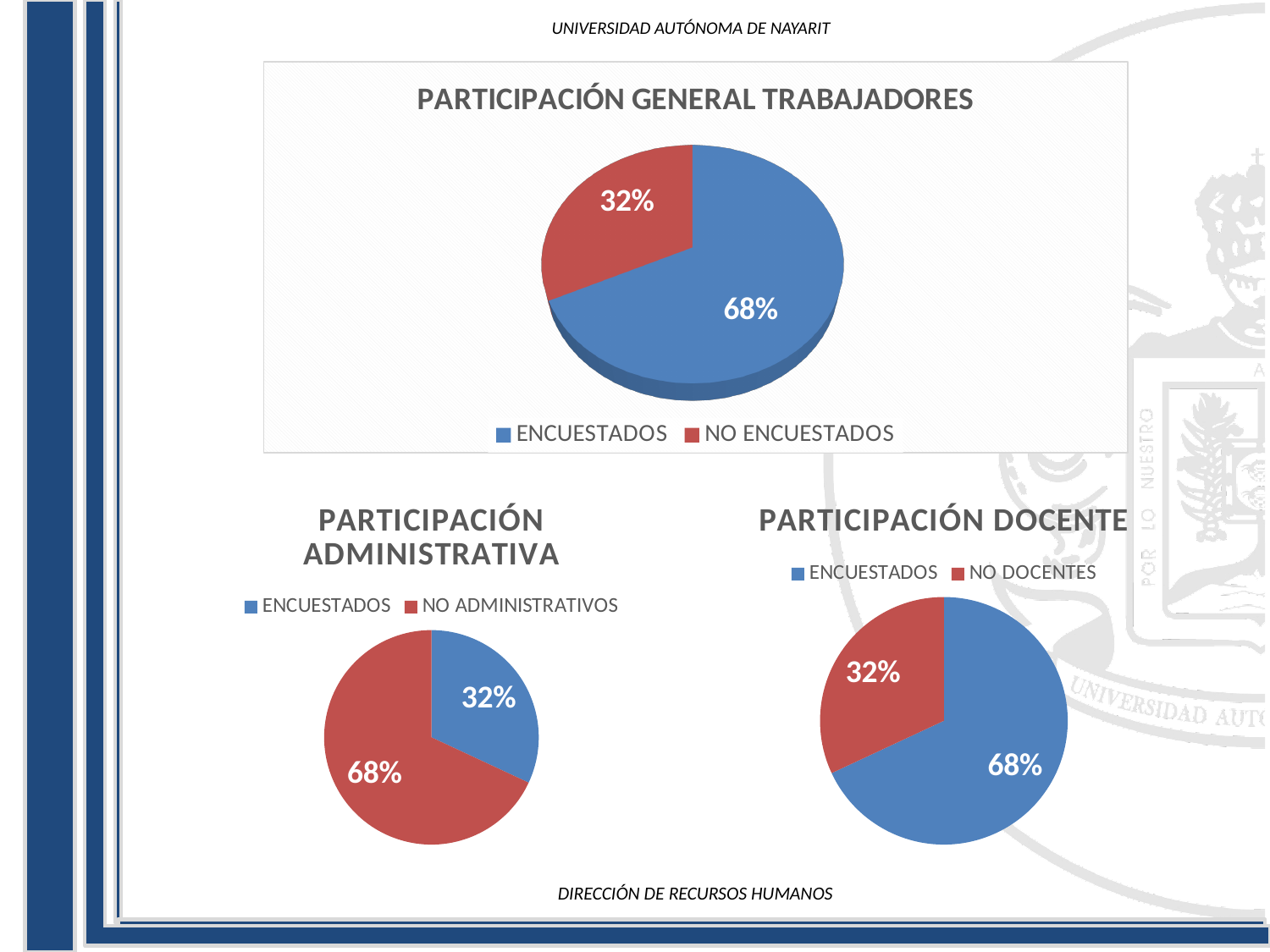
What kind of chart is 'PARTICIPACIÓN DOCENTE'? Pie chart In the 'PARTICIPACIÓN DOCENTE' chart, which category has the smallest slice? NO DOCENTES In the 'PARTICIPACIÓN ADMINISTRATIVA' chart, which category has the largest slice? NO ADMINISTRATIVOS In the 'PARTICIPACIÓN ADMINISTRATIVA' chart, which is larger, ENCUESTADOS or NO ADMINISTRATIVOS? NO ADMINISTRATIVOS How many categories does the legend of the 'PARTICIPACIÓN GENERAL TRABAJADORES' chart list? 2 In the 'PARTICIPACIÓN GENERAL TRABAJADORES' chart, what share of the pie is NO ENCUESTADOS? 32% In the 'PARTICIPACIÓN GENERAL TRABAJADORES' chart, what is the difference in percentage points between ENCUESTADOS and NO ENCUESTADOS? 36 percentage points In the 'PARTICIPACIÓN GENERAL TRABAJADORES' chart, what share of the pie is ENCUESTADOS? 68% In the 'PARTICIPACIÓN ADMINISTRATIVA' chart, what share of the pie is NO ADMINISTRATIVOS? 68%